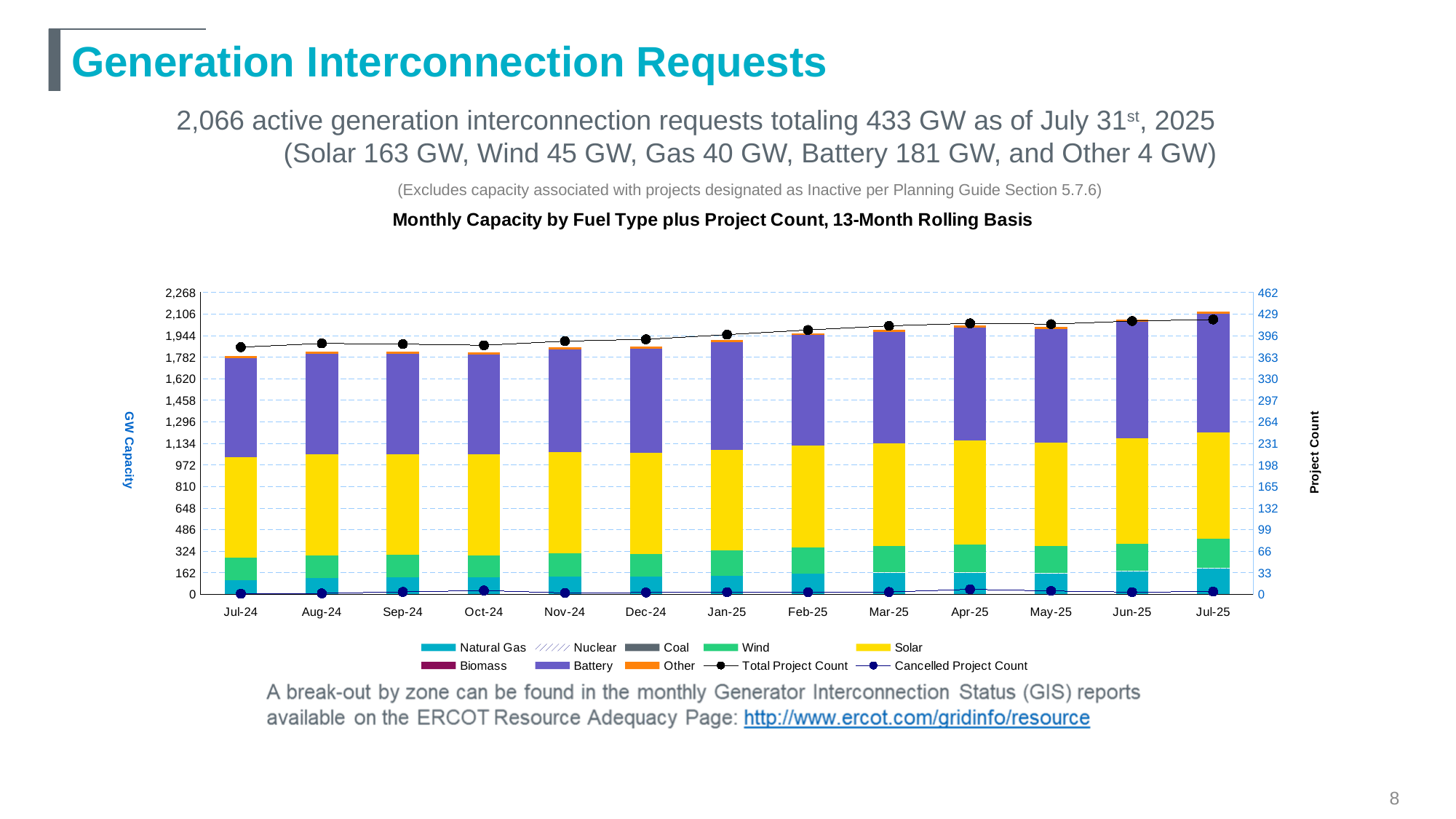
Is the total stacked bar for Jul-24 greater or less than 1,944 GW? less Which month has the tallest stacked bar (highest total GW capacity)? Jul-25 Is the Total Project Count for Jul-24 greater or less than 429? less How many months are shown along the x axis of the chart? 13 Is the total stacked bar for Jul-25 greater or less than 1,944 GW? greater How many series does the chart legend list? 10 What kind of chart is shown on the slide? Stacked bar chart with line series Does the Total Project Count line generally rise or fall from Jul-24 to Jul-25? rise What is the label of the right-hand vertical axis? Project Count Which has the larger total stacked bar, Jul-24 or Jul-25? Jul-25 What is the title of the chart? Monthly Capacity by Fuel Type plus Project Count, 13-Month Rolling Basis